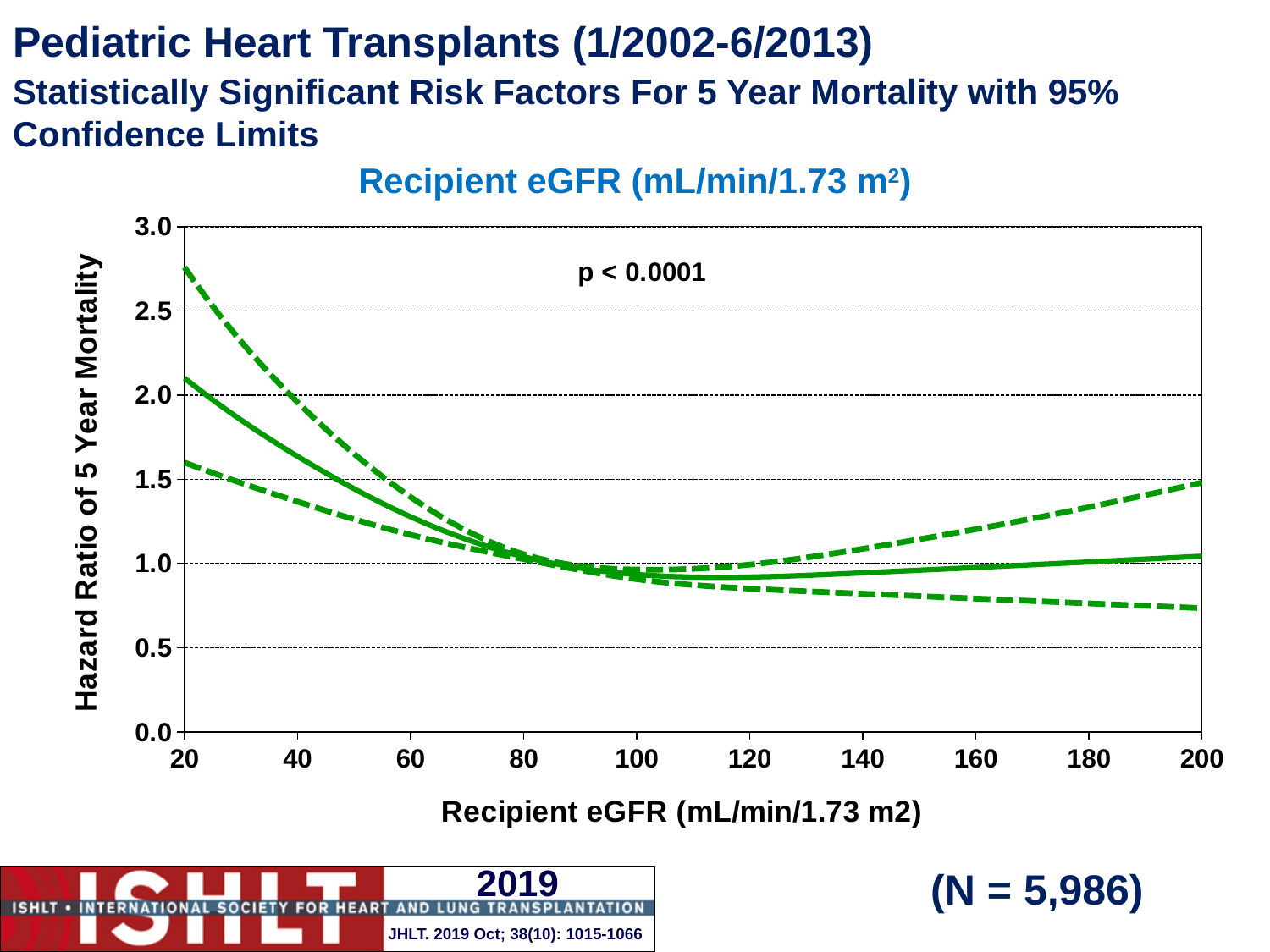
Is the value of the solid hazard ratio line at a recipient eGFR of 100 greater or less than 1.5? less What is the label of the y axis? Hazard Ratio of 5 Year Mortality What p-value is printed on the chart? p < 0.0001 What kind of chart is shown on the slide? line chart What is the title of the chart? Recipient eGFR (mL/min/1.73 m²) Between a recipient eGFR of 20 and 80, does the solid hazard ratio line rise or fall? fall Is the value of the lower dashed confidence limit at a recipient eGFR of 200 greater or less than 1.0? less Between a recipient eGFR of 120 and 200, does the upper dashed confidence limit rise or fall? rise Is the value of the upper dashed confidence limit at a recipient eGFR of 200 greater or less than 1.0? greater How many lines are plotted on the chart? 3